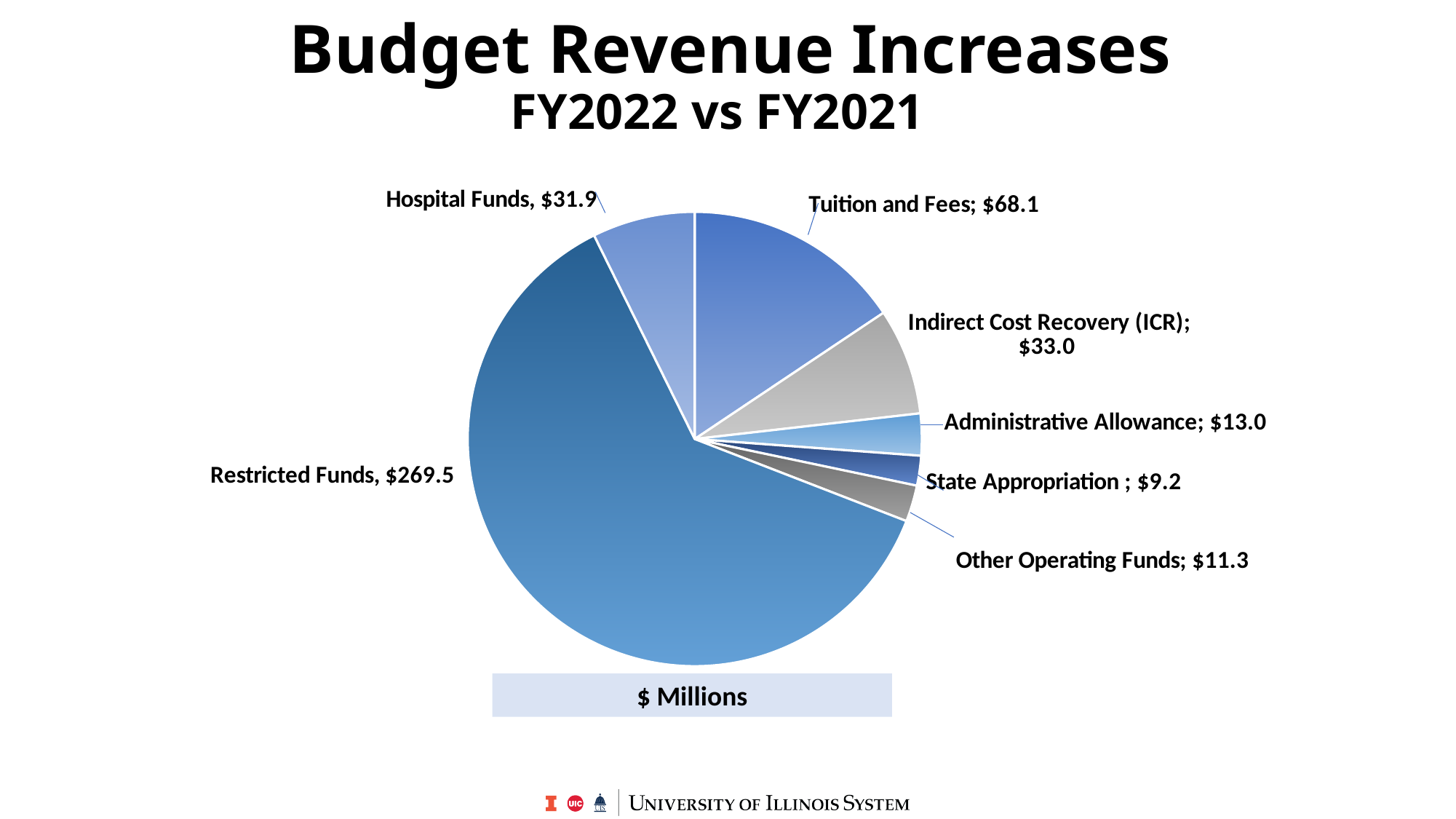
Which category has the largest slice of the pie? Restricted Funds What is the value for State Appropriation? $9.2 What is the difference between Tuition and Fees and Hospital Funds? $36.2 In what units are the values in the chart expressed? $ Millions Which is larger, Tuition and Fees or Other Operating Funds? Tuition and Fees What type of chart is shown on the slide? pie chart Which category has the smallest slice of the pie? State Appropriation What is the value for Tuition and Fees? $68.1 What is the difference between Indirect Cost Recovery (ICR) and Administrative Allowance? $20.0 How many categories are shown in the pie chart? 7 What is the value for Restricted Funds? $269.5 What is the value for Indirect Cost Recovery (ICR)? $33.0